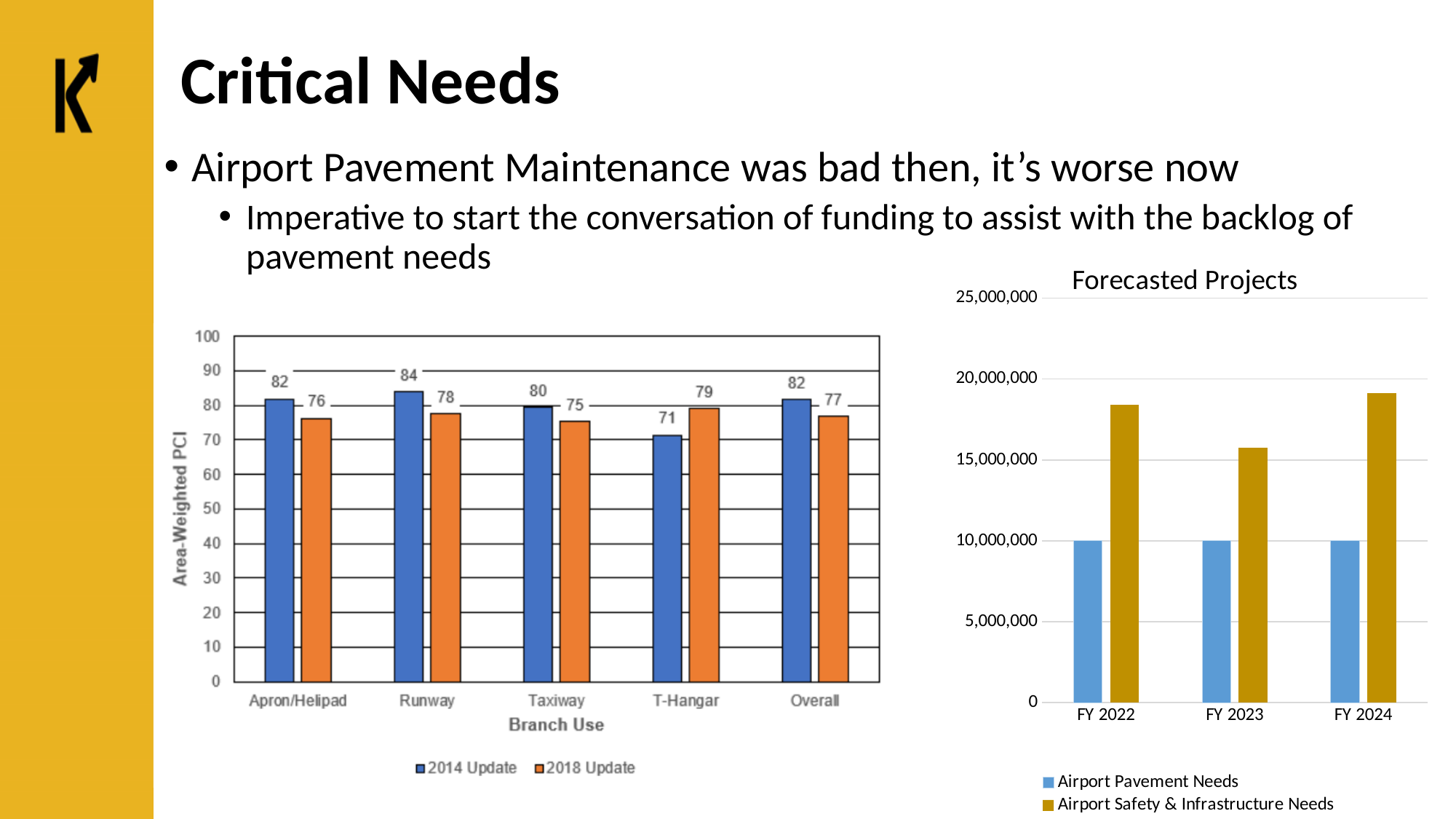
In the left chart of Area-Weighted PCI by Branch Use, which branch has the highest 2018 Update value? T-Hangar What kind of chart is the Forecasted Projects chart? Bar chart In the Forecasted Projects chart, which fiscal year has the lowest Airport Safety & Infrastructure Needs value? FY 2023 In the Forecasted Projects chart, is the value for Airport Safety & Infrastructure Needs in FY 2024 greater or less than 15,000,000? greater In the left chart of Area-Weighted PCI by Branch Use, how many series does the legend list? 2 In the left chart of Area-Weighted PCI by Branch Use, which is larger for Taxiway: the 2014 Update or the 2018 Update value? 2014 Update In the left chart of Area-Weighted PCI by Branch Use, what is the difference between the 2014 Update and 2018 Update values for Apron/Helipad? 6 In the left chart of Area-Weighted PCI by Branch Use, how many branch use categories are shown on the x axis? 5 In the left chart of Area-Weighted PCI by Branch Use, what is the 2018 Update value for T-Hangar? 79 In the left chart of Area-Weighted PCI by Branch Use, what is the 2014 Update value for Runway? 84 In the Forecasted Projects chart, what is the value for Airport Pavement Needs in FY 2023? 10,000,000 In the left chart of Area-Weighted PCI by Branch Use, which branch has the lowest 2014 Update value? T-Hangar